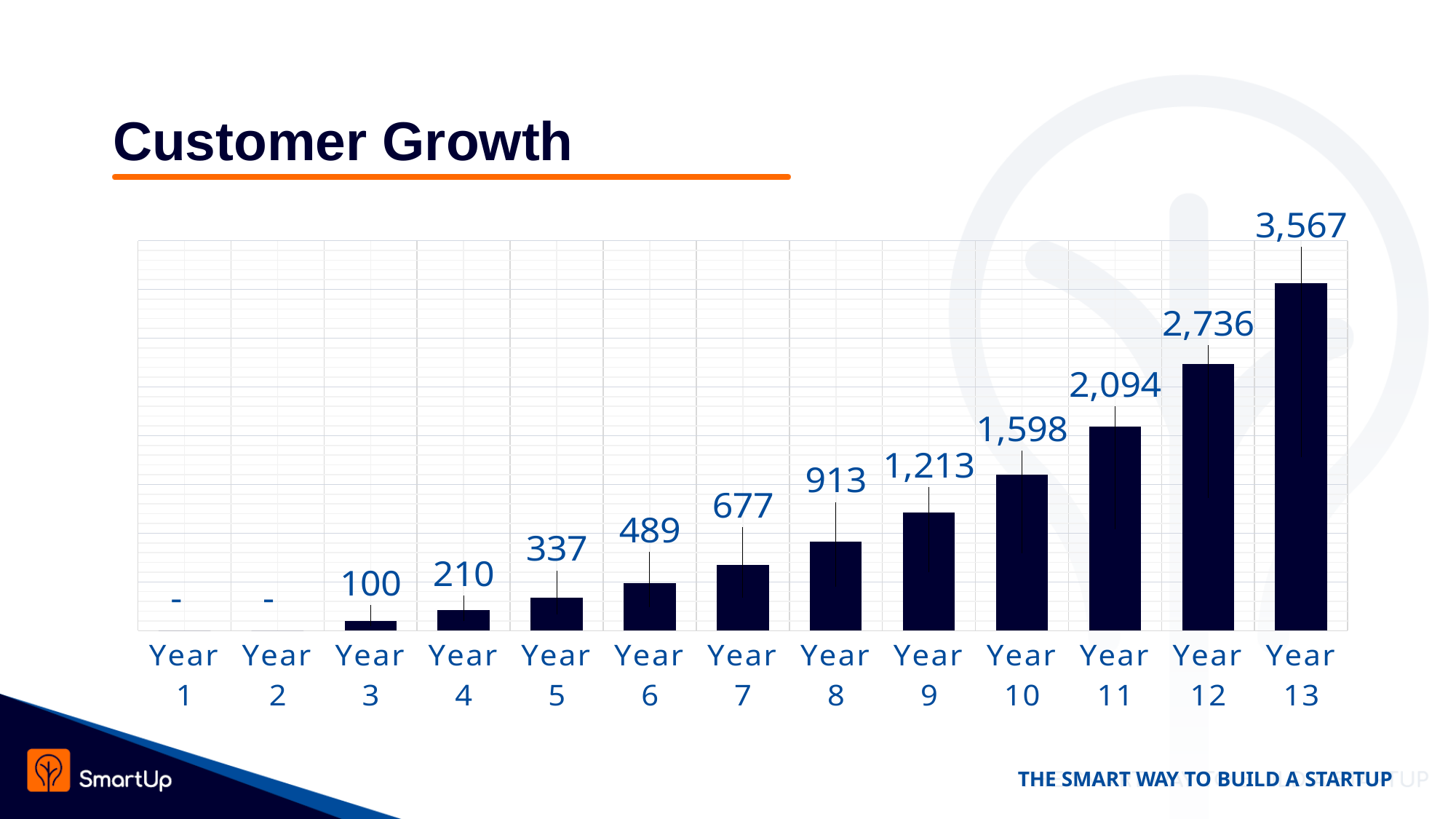
What is the value for Year 10? 1,598 How many years are shown on the x axis? 13 What is the difference between the values for Year 6 and Year 5? 152 Which year has the highest value? Year 13 What is the difference between the values for Year 13 and Year 12? 831 What is the value for Year 3? 100 Which is larger, the value for Year 9 or the value for Year 11? Year 11 What is the title of the chart? Customer Growth What is the value for Year 8? 913 Do the values rise or fall from Year 3 to Year 13? Rise What kind of chart is this? Bar chart What is the value for Year 13? 3,567